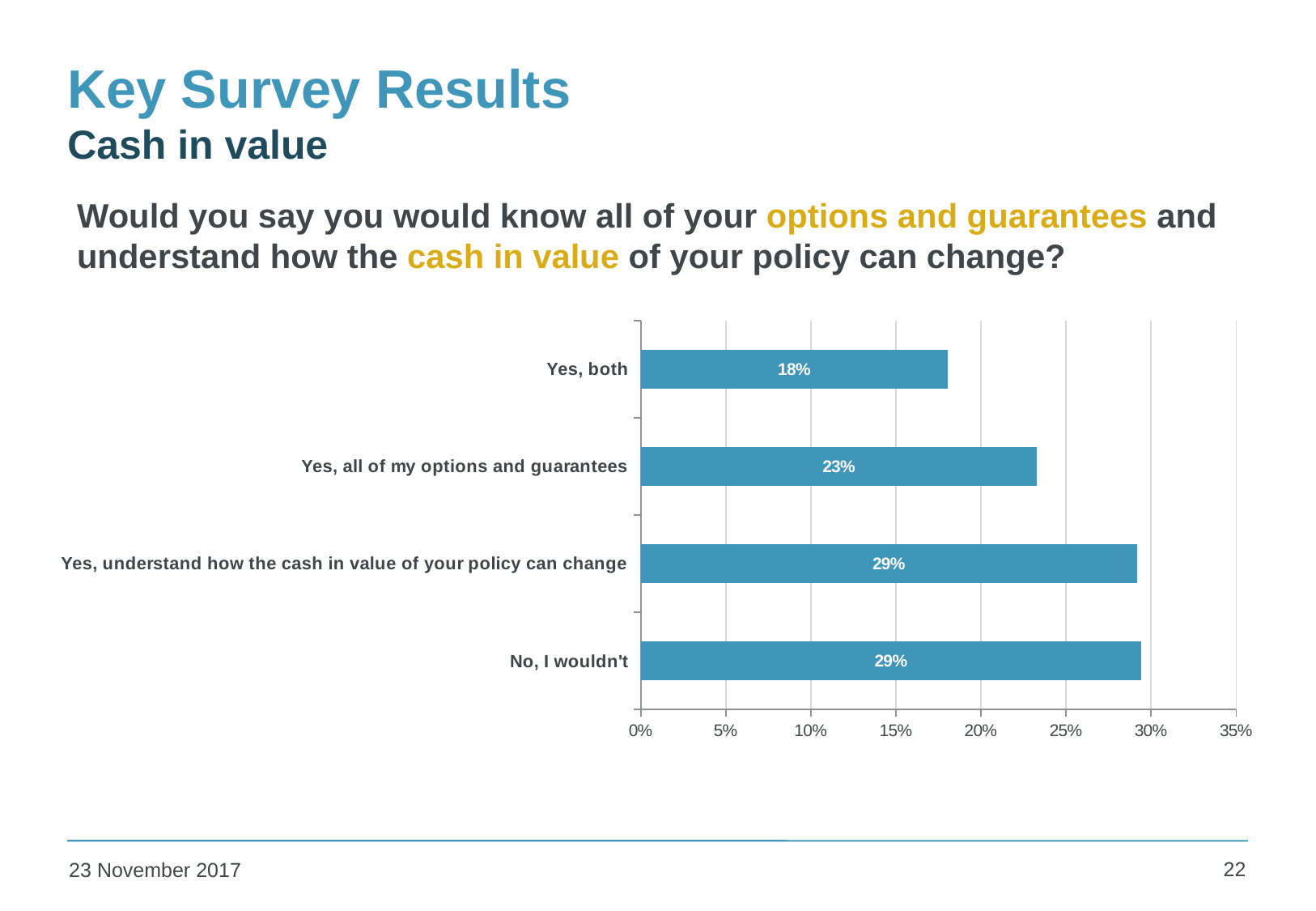
How many response categories are shown in the chart? 4 Which response category has the lowest value? Yes, both Is the value for "Yes, both" greater or less than 20%? less What is the value for "Yes, understand how the cash in value of your policy can change"? 29% What kind of chart is shown on the slide? bar chart What percentage answered "No, I wouldn't"? 29% Which is larger: "Yes, both" or "Yes, all of my options and guarantees"? Yes, all of my options and guarantees What is the highest value shown on the horizontal axis? 35% What is the value for "Yes, all of my options and guarantees"? 23% What percentage of respondents answered "Yes, both"? 18% What is the difference between "No, I wouldn't" and "Yes, both"? 11% What is the difference between "Yes, all of my options and guarantees" and "Yes, both"? 5%